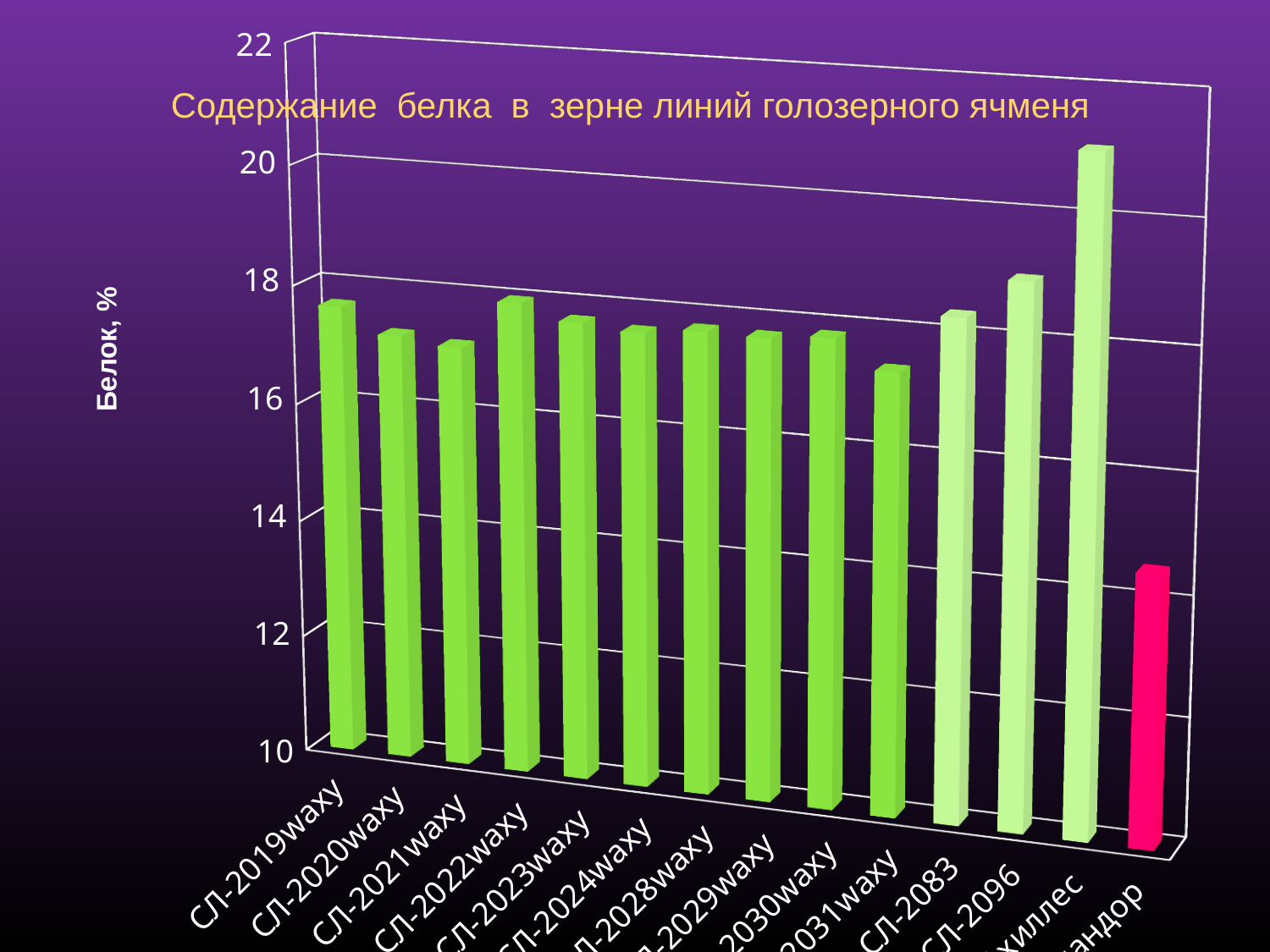
What is the title of the chart? Содержание белка в зерне линий голозерного ячменя Which has a higher protein content, СЛ-2083 or СЛ-2096? СЛ-2096 Which bar has the lowest protein content? the rightmost bar (Командор) Is the value for СЛ-2031waxy greater or less than 18? less Is the value for СЛ-2019waxy greater or less than 16? greater What is the label of the vertical axis? Белок, % What kind of chart is shown on the slide? bar chart Is the value for the tallest bar greater or less than 18? greater Which has a higher protein content, СЛ-2021waxy or СЛ-2022waxy? СЛ-2022waxy Which bar has the highest protein content? the second bar from the right (Ахиллес) How many bars are plotted in the chart? 14